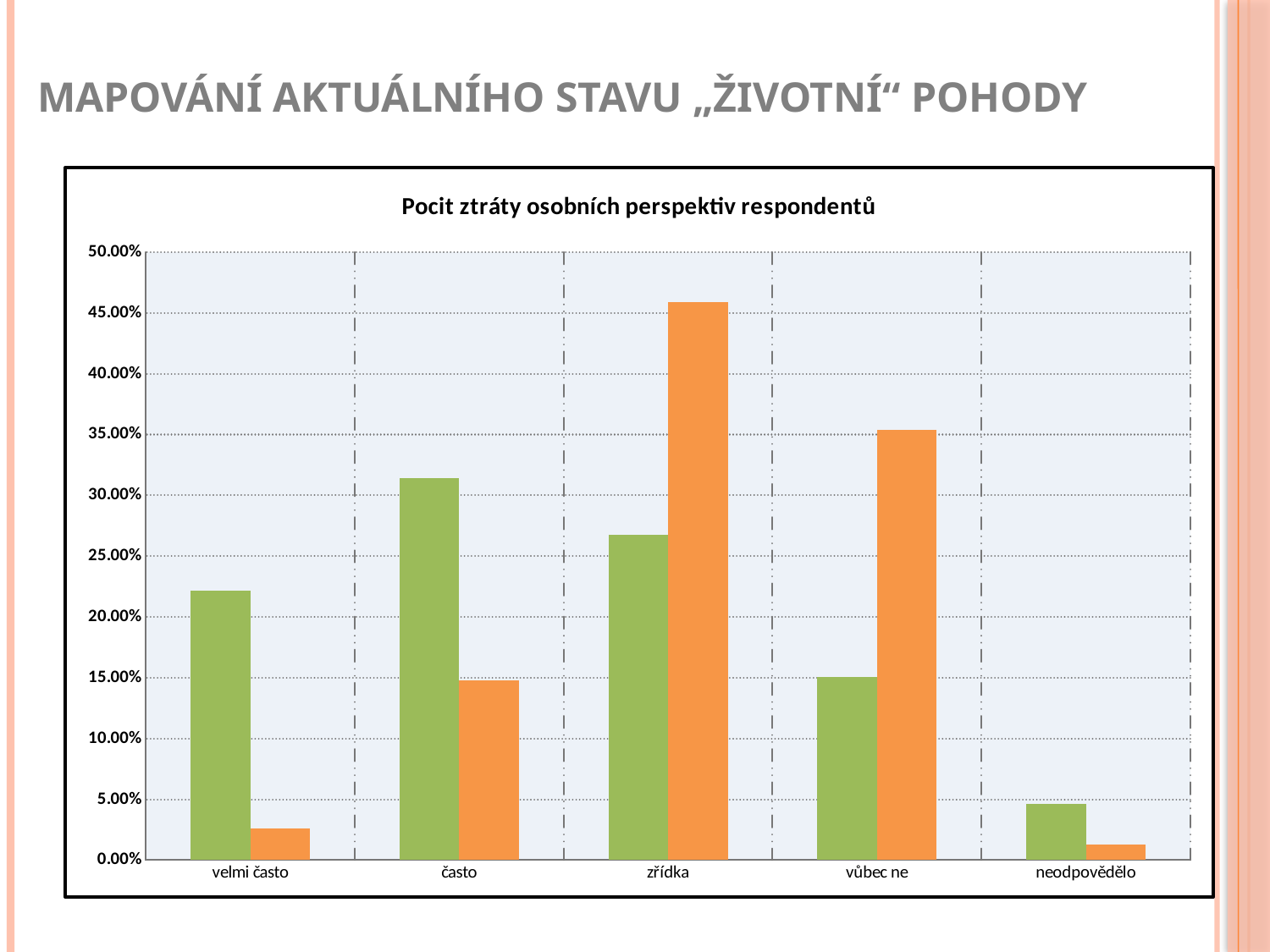
Which category has the shortest green bar? neodpovědělo Is the orange bar for zřídka greater or less than 40.00%? greater For the category velmi často, which bar is taller, the green one or the orange one? green How many categories are shown on the x axis of the chart? 5 Which category has the tallest orange bar? zřídka What is the title of the chart? Pocit ztráty osobních perspektiv respondentů Is the orange bar for velmi často greater or less than 5.00%? less Which category has the tallest green bar? často For the category zřídka, which bar is taller, the green one or the orange one? orange Is the green bar for velmi často greater or less than 20.00%? greater What type of chart is shown on the slide? bar chart How many bars are shown for each category in the chart? 2